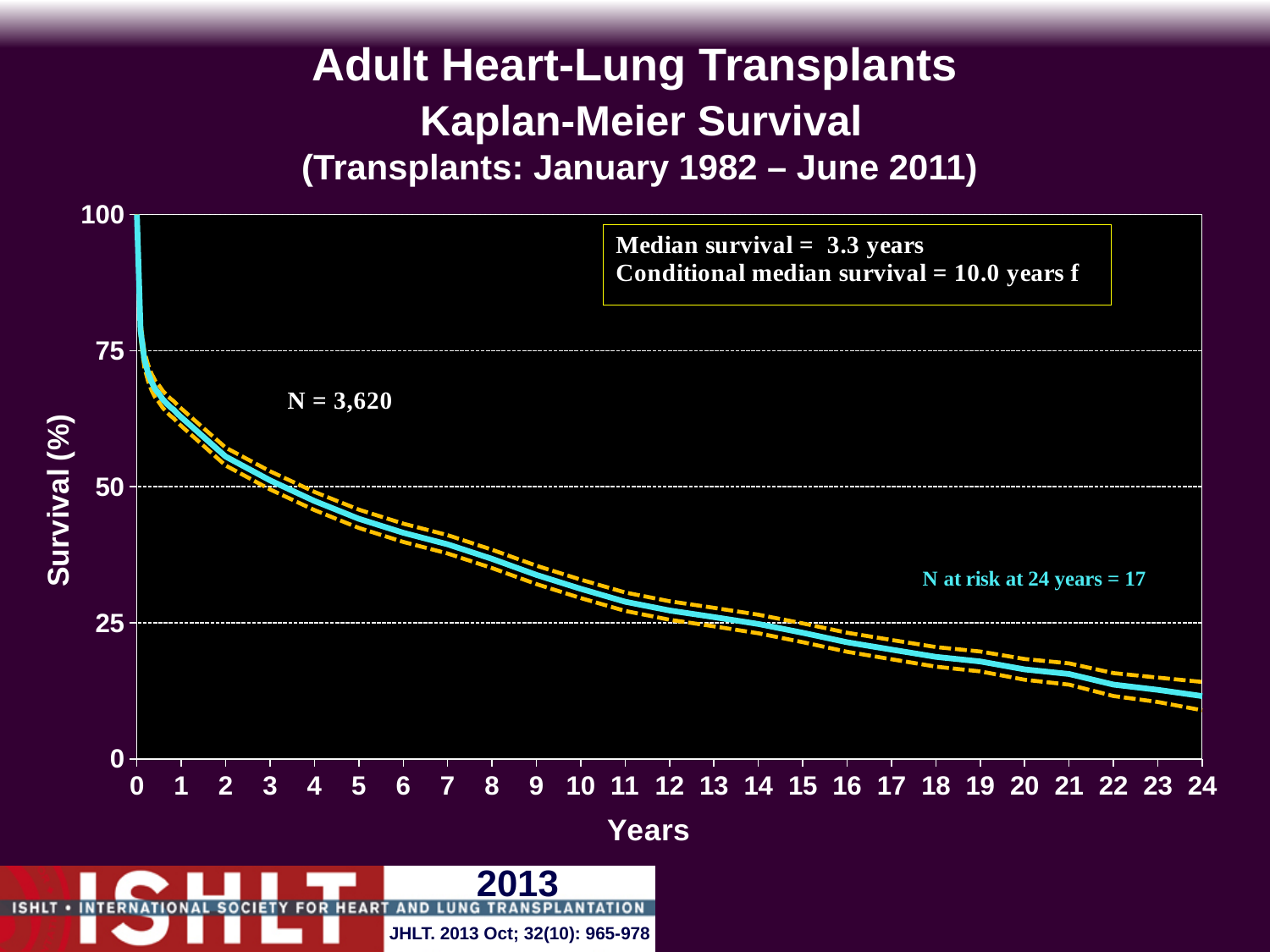
Is the survival value at 24 years greater or less than 25? less Is the survival value at 1 year greater or less than 50? greater What is the value of N shown on the chart? 3,620 Does the survival curve rise or fall as years increase? fall What is the label of the y axis? Survival (%) Is the survival value at 20 years greater or less than 25? less What is the N at risk at 24 years? 17 What is the median survival reported on the chart? 3.3 years What is the highest value shown on the x axis? 24 What kind of chart is shown on the slide? line chart What is the conditional median survival reported on the chart? 10.0 years